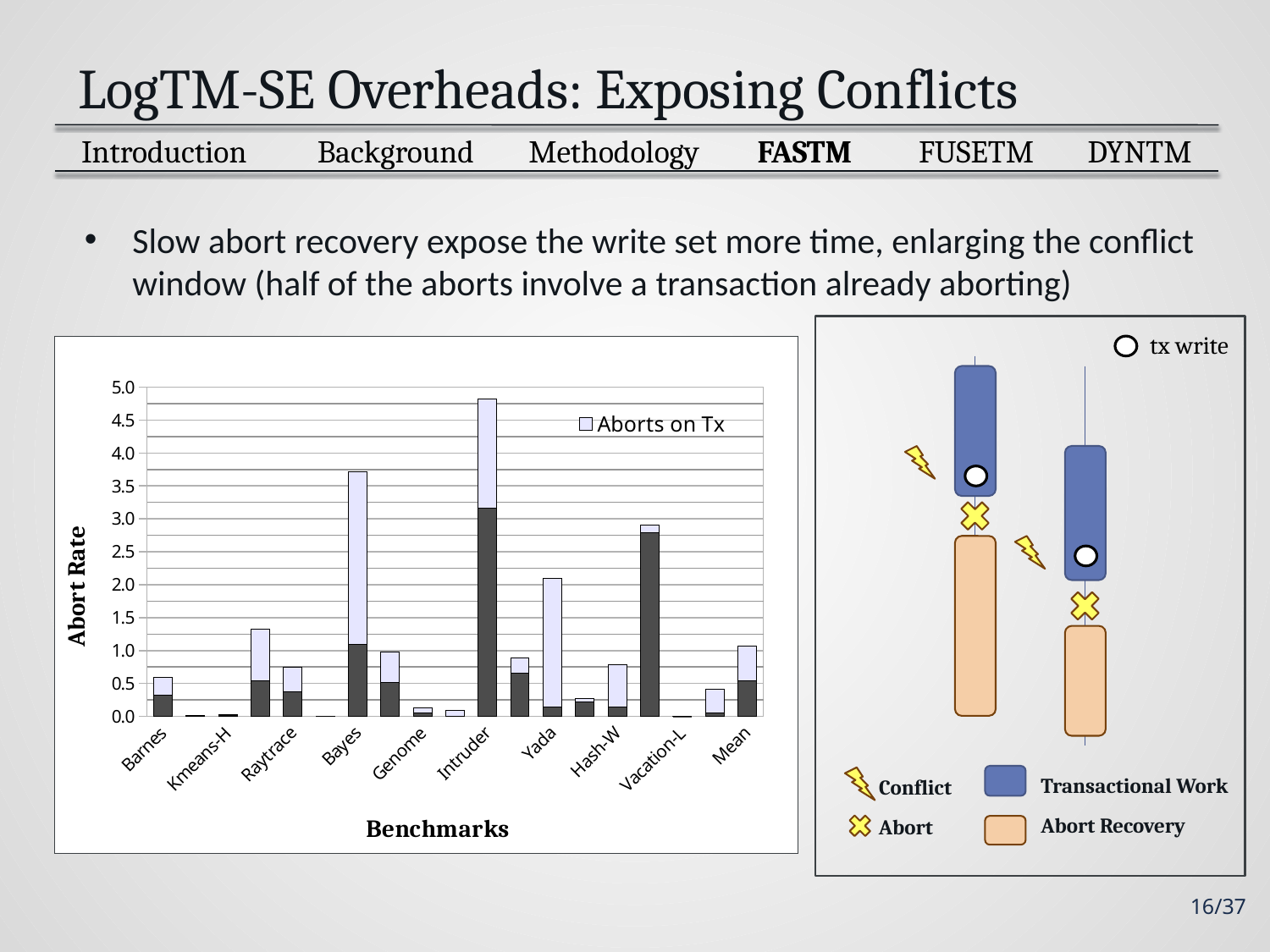
Is the total abort rate for Raytrace greater or less than 1.0? less How many series does the chart's legend list? 1 Is the total abort rate for Mean greater or less than 1.5? less Which has a higher total abort rate, Raytrace or Genome? Raytrace Is the total abort rate for Intruder greater or less than 4.5? greater How many benchmark categories are plotted along the x axis of the chart? 19 Which has a higher total abort rate, Bayes or Vacation-L? Bayes Which benchmark has the highest total abort rate in the chart? Intruder What is the title of the chart's y axis? Abort Rate What kind of chart is shown on the slide? Stacked bar chart